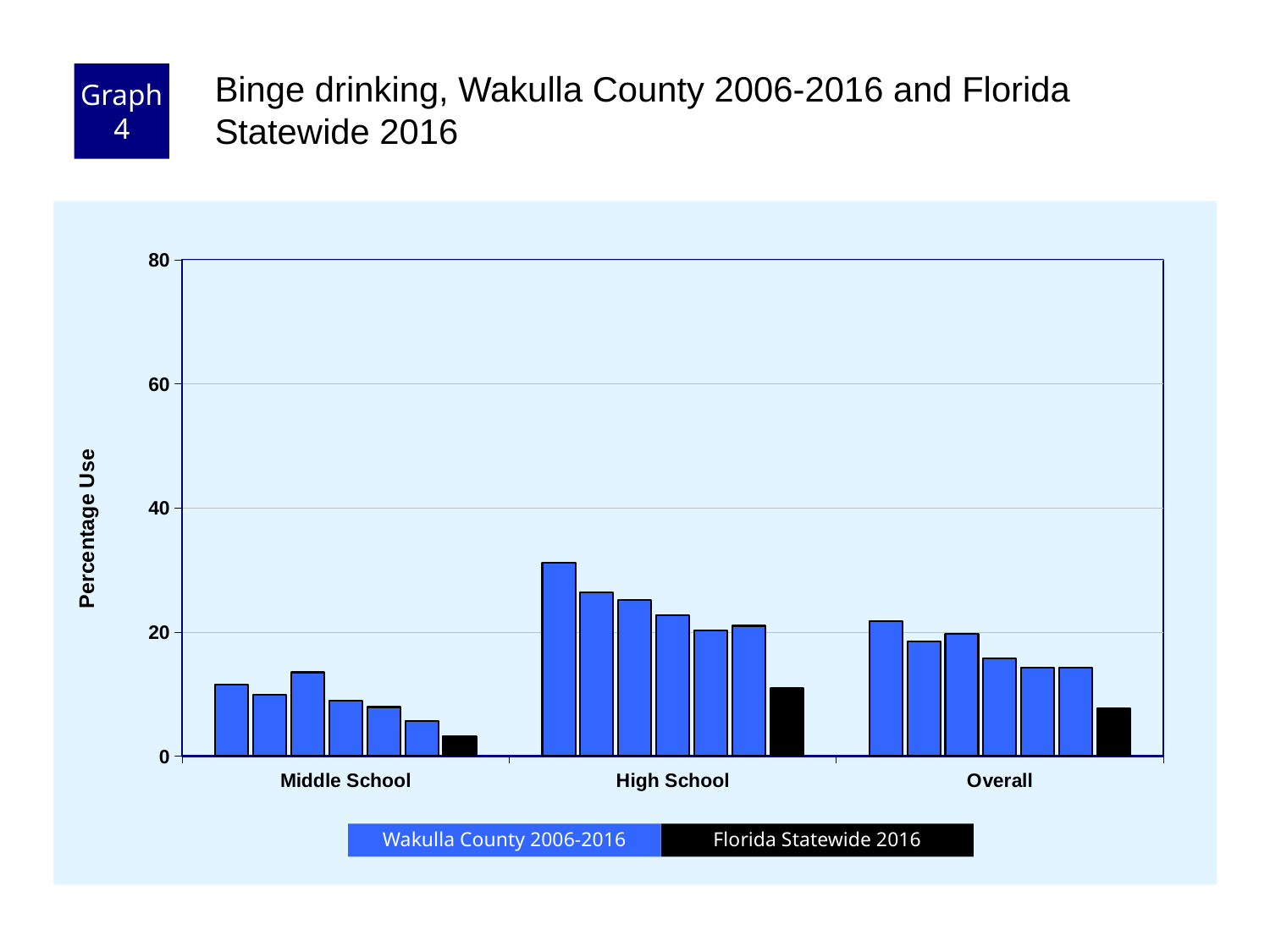
Is the Florida Statewide 2016 value for High School greater or less than 20? less What is the label on the y axis? Percentage Use What kind of chart is shown on the slide? bar chart Which category has the lowest Florida Statewide 2016 bar? Middle School Which is larger, the Florida Statewide 2016 bar for High School or for Overall? High School How many categories are shown along the x axis? 3 How many series does the legend list? 2 Within the High School category, do the Wakulla County bars rise or fall from left to right? fall Is the tallest Wakulla County bar for High School greater or less than 40? less Is the tallest Wakulla County bar for High School greater or less than 20? greater Which category has the highest Florida Statewide 2016 bar? High School